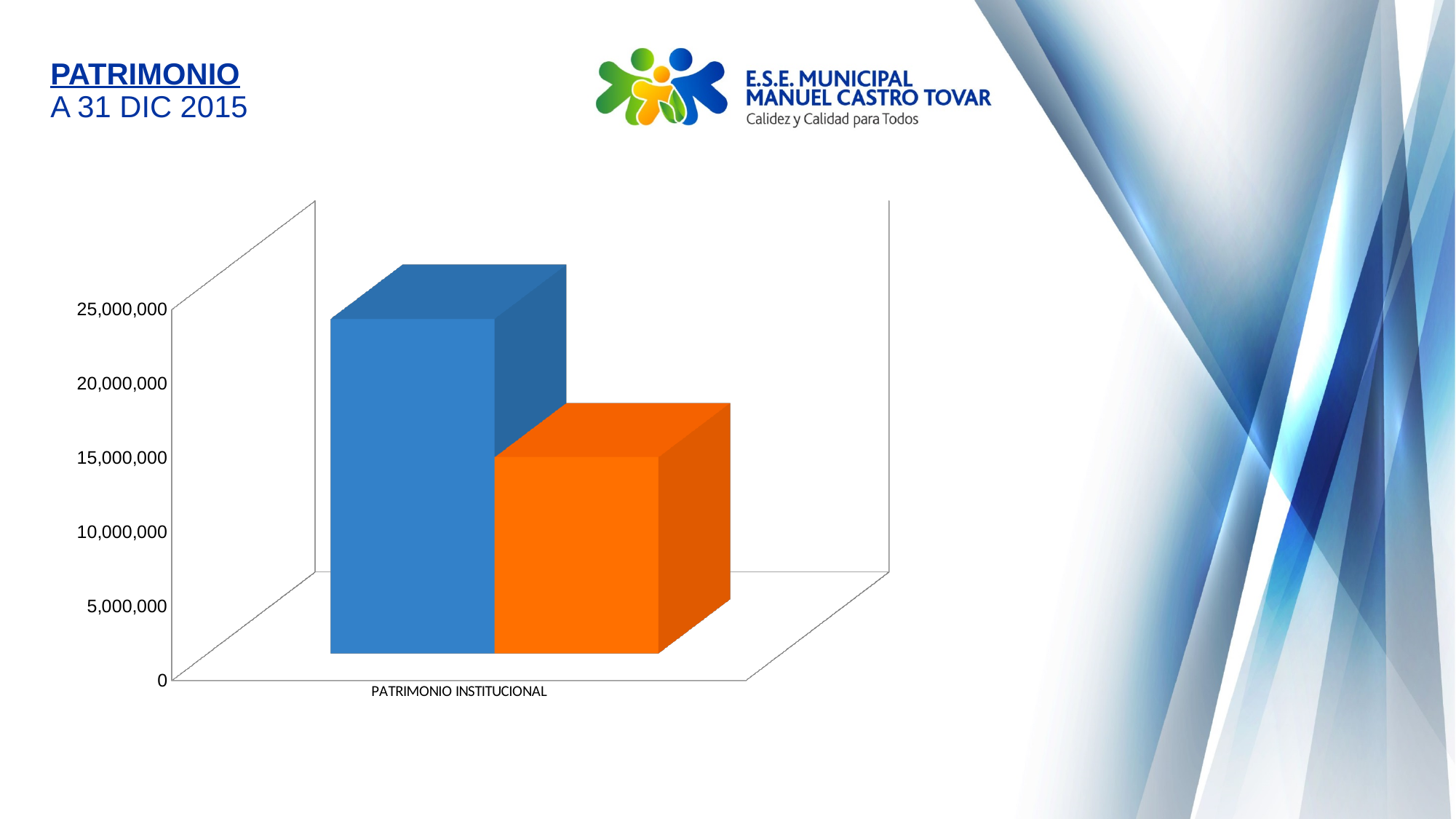
What is the label of the category on the x axis? PATRIMONIO INSTITUCIONAL Is the value of the orange bar greater or less than 10,000,000? greater Is the value of the orange bar greater or less than 20,000,000? less How many categories are shown on the x axis of the chart? 1 How many bars are plotted for PATRIMONIO INSTITUCIONAL? 2 Is the value of the blue bar greater or less than 20,000,000? greater Which bar has the lowest value, the blue or the orange? the orange bar What kind of chart is shown on the slide? bar chart What is the highest value shown on the vertical axis? 25,000,000 Which bar is taller, the blue bar or the orange bar? the blue bar